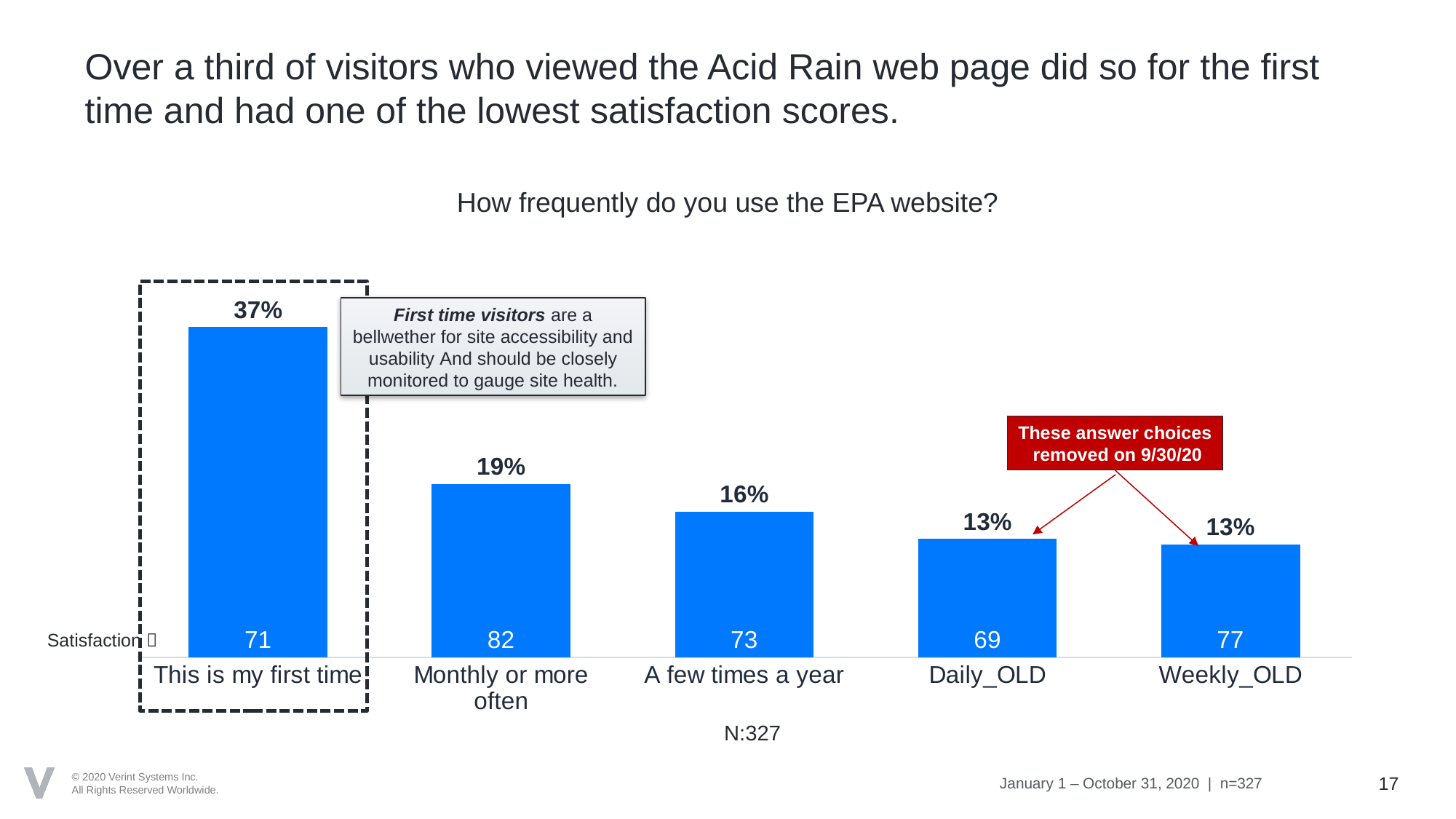
Which category has the highest satisfaction score? Monthly or more often Which has a higher satisfaction score, "Weekly_OLD" or "This is my first time"? Weekly_OLD Which category has the lowest satisfaction score? Daily_OLD What is the satisfaction score shown for "Daily_OLD"? 69 What percentage of respondents answered "This is my first time"? 37% What is the satisfaction score shown for "A few times a year"? 73 How many categories are shown in the chart? 5 What is the title of the chart? How frequently do you use the EPA website? What type of chart is shown on the slide? Bar chart What is the difference in percentage between "This is my first time" and "Monthly or more often"? 18% Which category has the highest percentage of respondents? This is my first time What percentage of respondents answered "Monthly or more often"? 19%